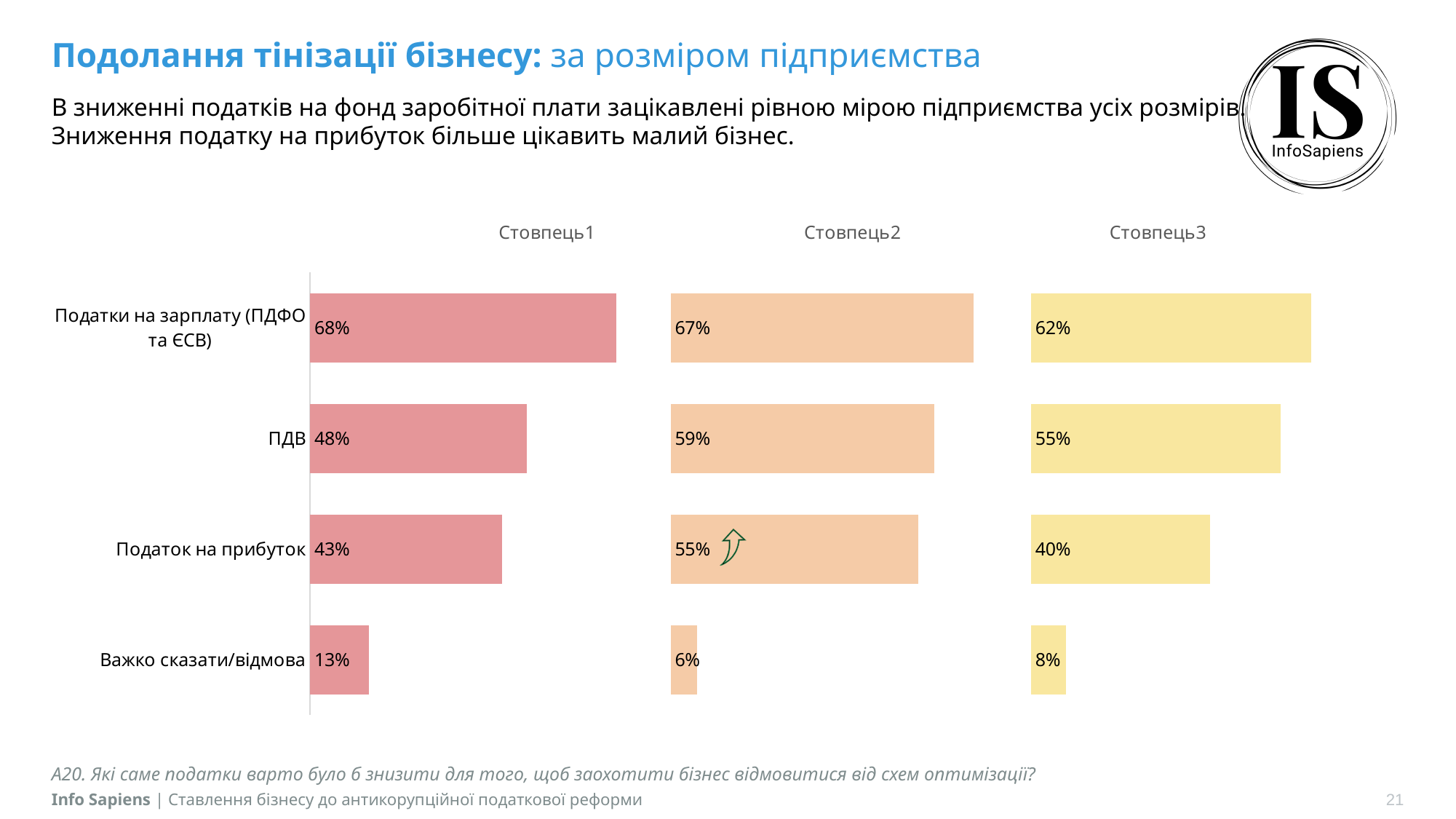
Which category has the lowest value in the Стовпець1 series? Важко сказати/відмова What is the difference between the Стовпець1 and Стовпець3 values for Важко сказати/відмова? 5% What is the value for ПДВ in the Стовпець2 series? 59% What kind of chart is shown on the slide? bar chart What is the difference between the Стовпець2 and Стовпець1 values for ПДВ? 11% What is the value for Податок на прибуток in the Стовпець3 series? 40% How many categories are shown in the chart? 4 How many series does the chart show? 3 Which series has the larger value for Податок на прибуток, Стовпець2 or Стовпець3? Стовпець2 What is the value for Важко сказати/відмова in the Стовпець2 series? 6% Which category has the highest value in the Стовпець3 series? Податки на зарплату (ПДФО та ЄСВ) What is the value for Податки на зарплату (ПДФО та ЄСВ) in the Стовпець1 series? 68%